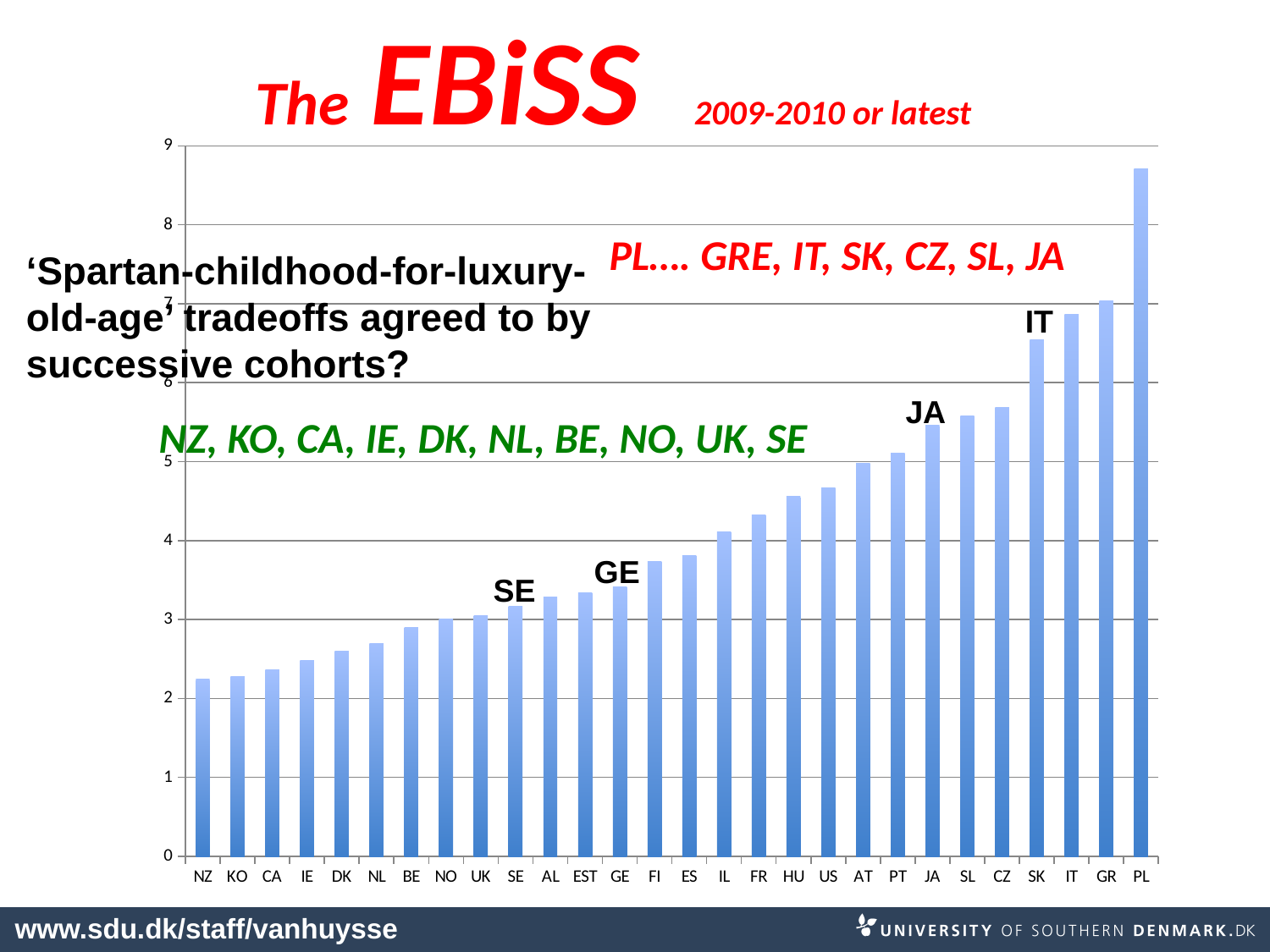
Which has the larger value, SE or US? US Do the bar values rise or fall from left to right along the x axis? rise Is the value for PL greater or less than 8? greater How many categories are plotted along the x axis? 28 Which category has the highest bar? PL Is the value for SK greater or less than 6? greater What period does the subtitle next to the chart title say the data covers? 2009-2010 or latest Is the value for NZ greater or less than 3? less Which has the larger value, IT or JA? IT What kind of chart is shown on the slide? bar chart Which category has the lowest bar? NZ